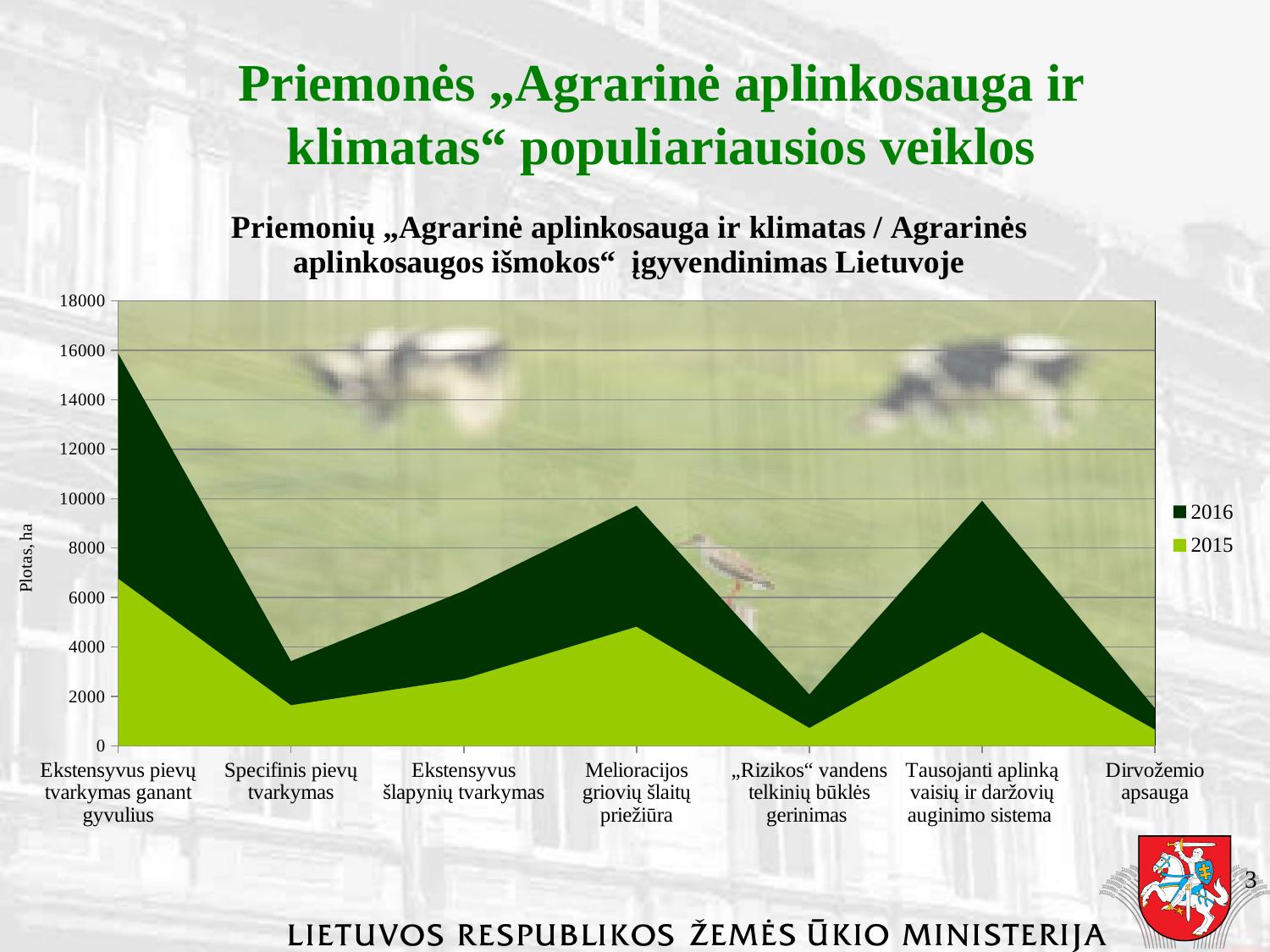
How many categories are shown along the x axis? 7 Is the 2015 value for „Rizikos“ vandens telkinių būklės gerinimas greater or less than 2000? less Is the 2015 value for Ekstensyvus pievų tvarkymas ganant gyvulius greater or less than 6000? greater Which years are listed in the chart legend? 2016 and 2015 Is the 2015 value for Specifinis pievų tvarkymas greater or less than 2000? less What is the label of the vertical axis? Plotas, ha What kind of chart is shown on the slide? area chart How many series does the legend list? 2 Which has the larger 2015 value: Ekstensyvus pievų tvarkymas ganant gyvulius or Specifinis pievų tvarkymas? Ekstensyvus pievų tvarkymas ganant gyvulius Which category has the highest 2015 value? Ekstensyvus pievų tvarkymas ganant gyvulius